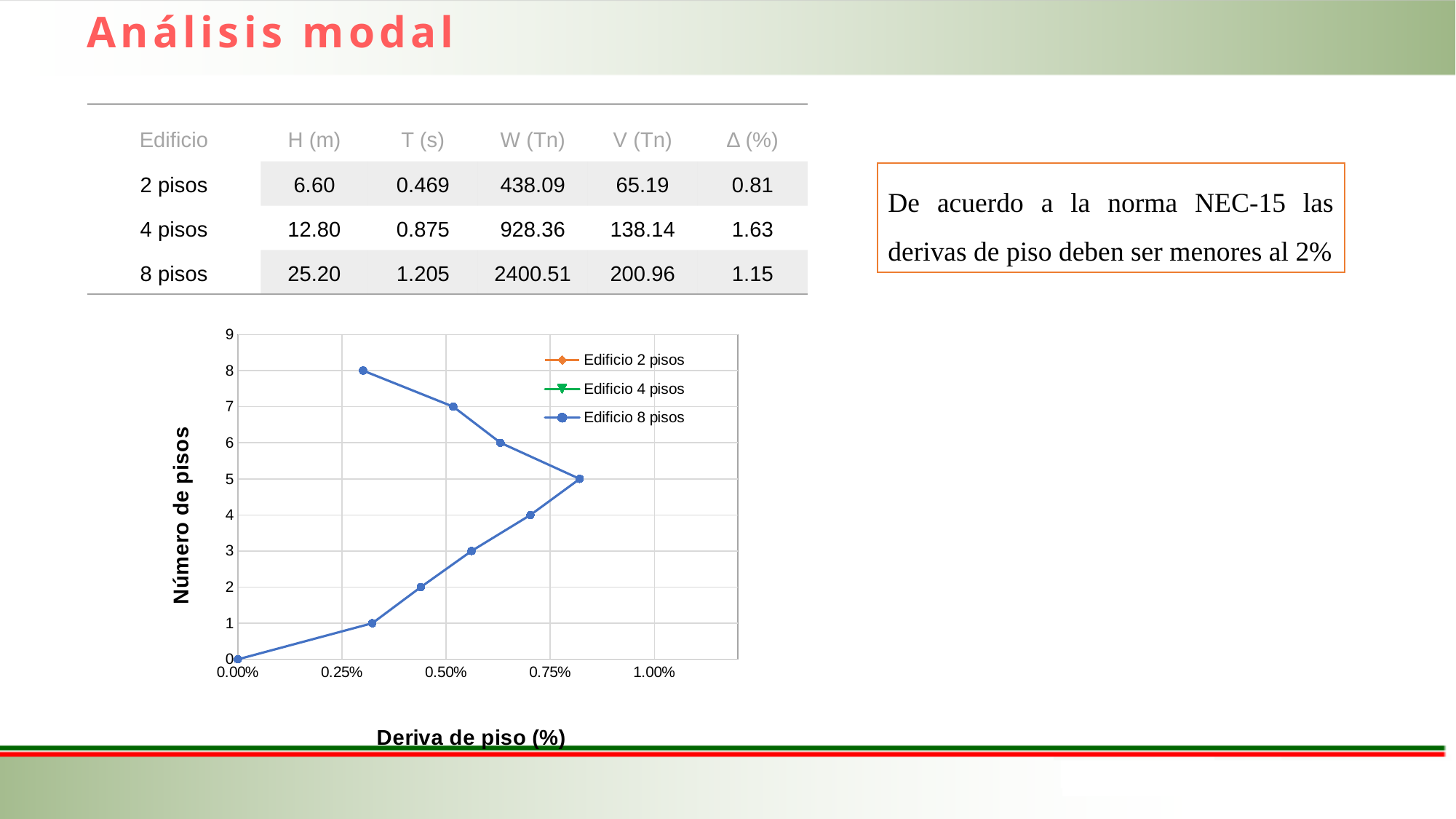
What is the drift value for Edificio 8 pisos at floor 0? 0.00% Does the drift for Edificio 8 pisos rise or fall from floor 5 to floor 8? fall At which floor number does the Edificio 8 pisos series reach its highest drift? 5 Is the drift for Edificio 8 pisos at floor 5 greater or less than 0.75%? greater What kind of chart is shown on the slide? line chart Which has a larger drift for Edificio 8 pisos: floor 5 or floor 3? floor 5 What is the label of the x axis of the chart? Deriva de piso (%) How many series does the chart legend list? 3 What is the label of the y axis of the chart? Número de pisos At which floor number is the drift for Edificio 8 pisos lowest? 0 Is the drift for Edificio 8 pisos at floor 2 greater or less than 0.50%? less How many data points are plotted for the Edificio 8 pisos series? 9